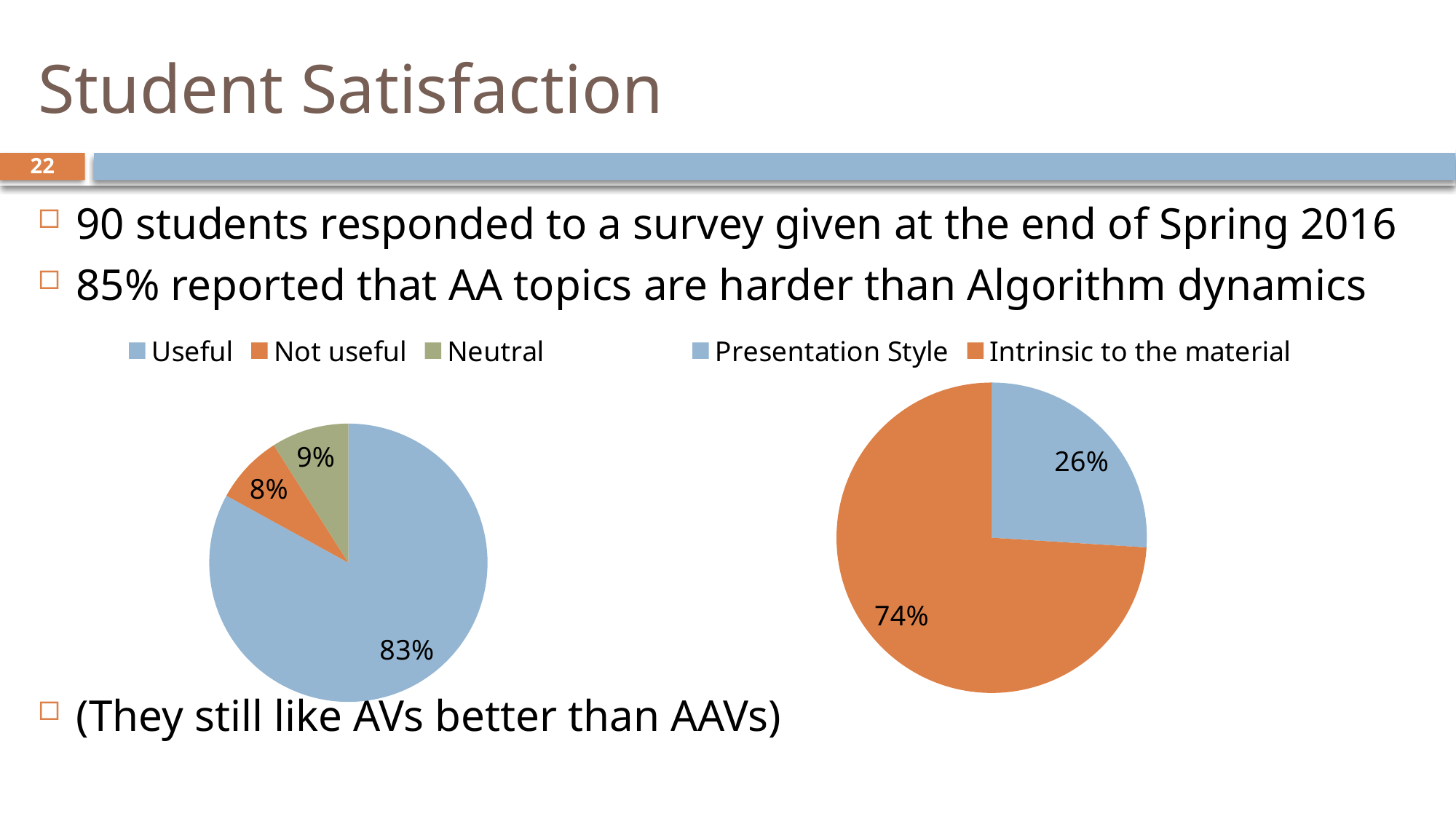
What type of chart is the left chart on the slide? Pie chart In the left pie chart, what percentage is labelled for Useful? 83% In the left pie chart, which category has the smallest slice? Not useful In the left pie chart, what percentage is labelled for Neutral? 9% In the right pie chart, which category has the larger slice? Intrinsic to the material How many slices does the left pie chart have? 3 In the right pie chart, what percentage is labelled for Presentation Style? 26% In the left pie chart, what percentage is labelled for Not useful? 8% In the right pie chart, what percentage is labelled for Intrinsic to the material? 74% How many entries does the legend of the right pie chart list? 2 In the left pie chart, which category has the largest slice? Useful In the right pie chart, what is the difference in percentage points between Intrinsic to the material and Presentation Style? 48